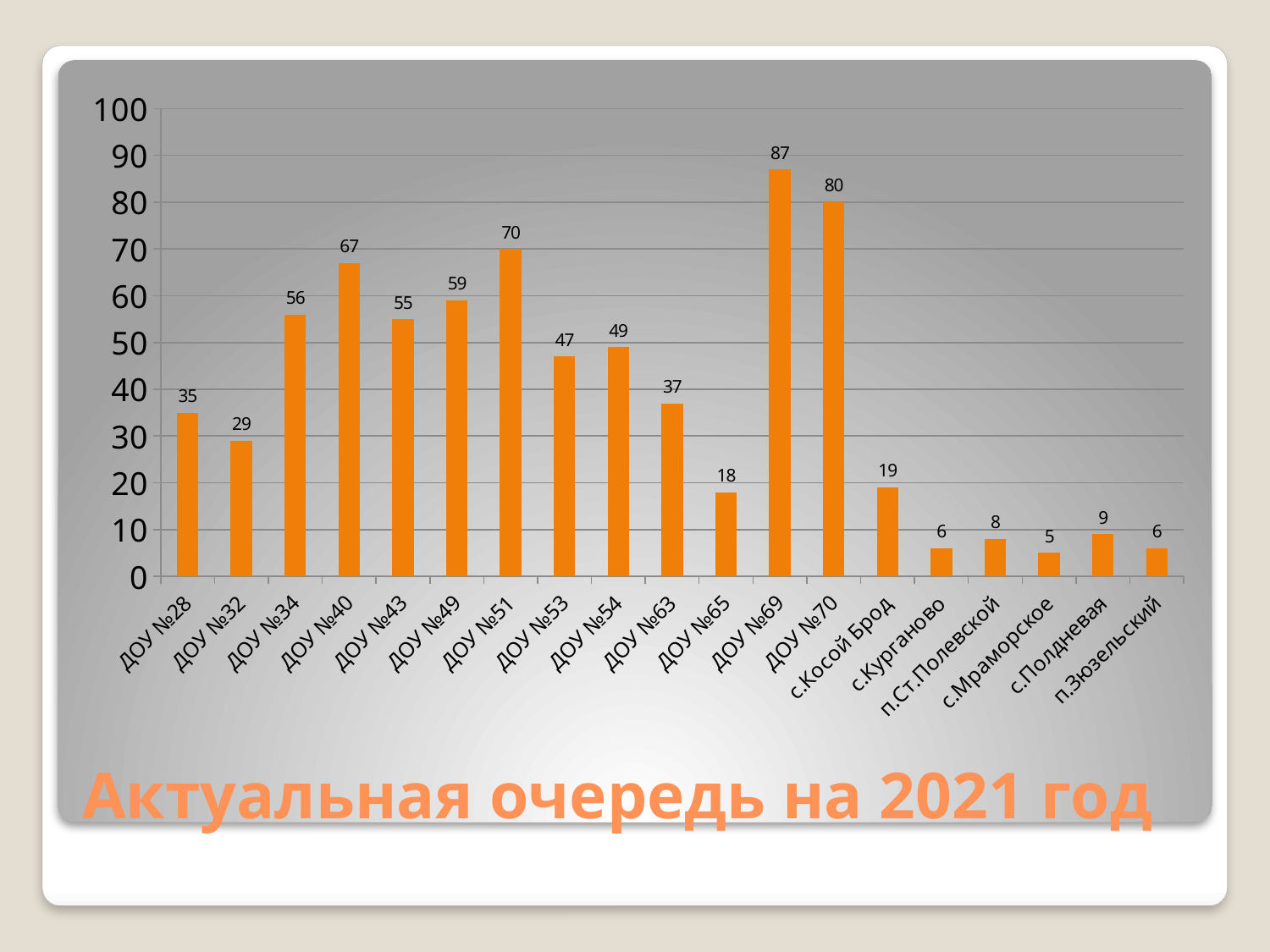
What is the title of the chart? Актуальная очередь на 2021 год Which is larger, the value for ДОУ №34 or the value for ДОУ №43? ДОУ №34 Which category has the highest value? ДОУ №69 What is the value for ДОУ №65? 18 How many categories are shown on the x axis? 19 Is the value for ДОУ №63 greater or less than 40? less Which category has the lowest value? с.Мраморское What is the difference between the values for ДОУ №69 and ДОУ №70? 7 What is the value for ДОУ №40? 67 What is the value for с.Косой Брод? 19 What is the difference between the values for ДОУ №51 and ДОУ №32? 41 What kind of chart is shown on the slide? bar chart